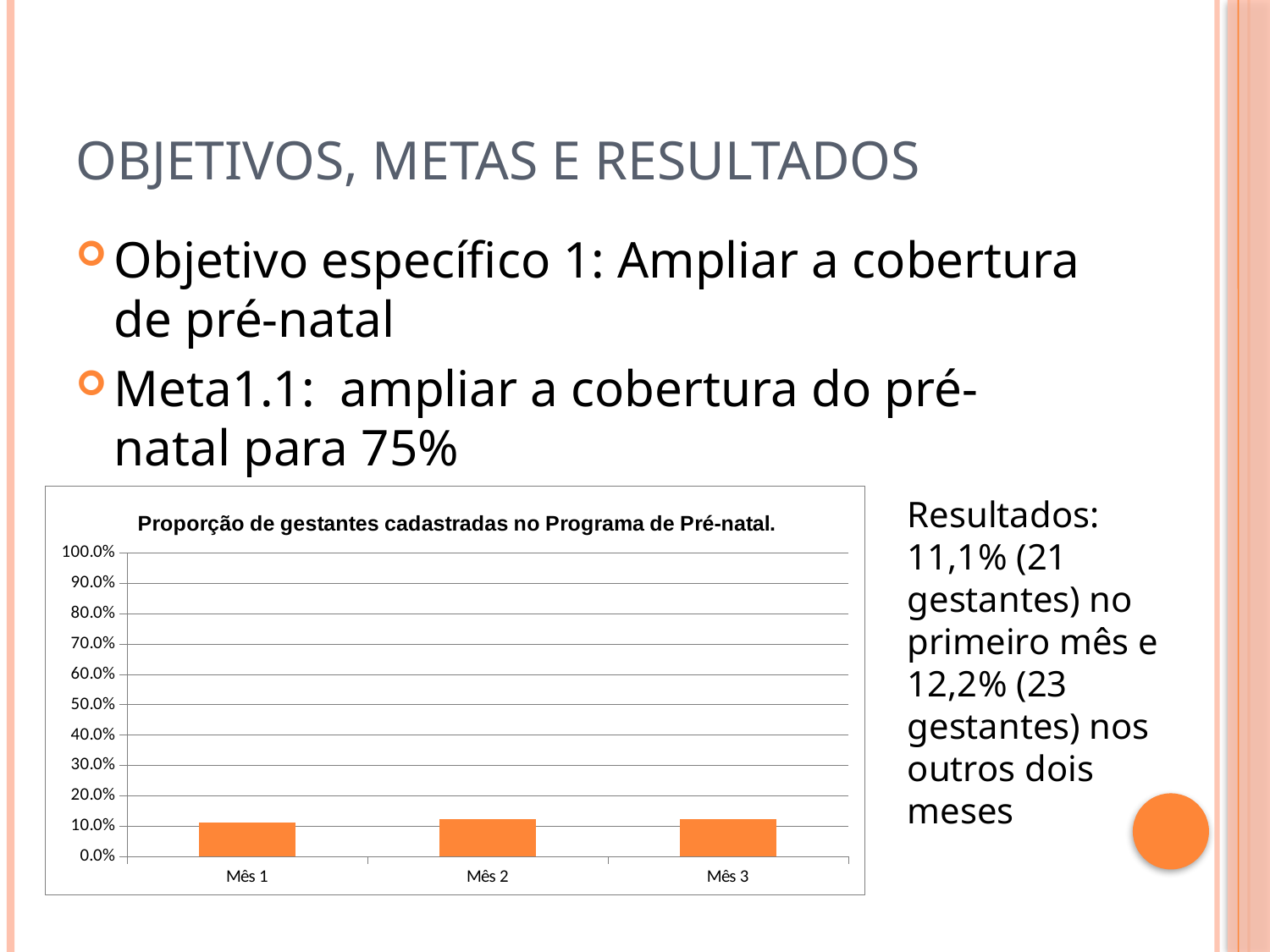
What kind of chart is shown on the slide? bar chart Is the value for Mês 2 greater or less than 20.0%? less Is the value for Mês 3 greater or less than 0.0%? greater Is the value for Mês 3 greater or less than 30.0%? less What is the label of the last category on the x axis? Mês 3 What is the label of the first category on the x axis? Mês 1 What is the title of the chart? Proporção de gestantes cadastradas no Programa de Pré-natal. How many categories are shown on the x axis of the chart? 3 What is the highest value shown on the y axis of the chart? 100.0%